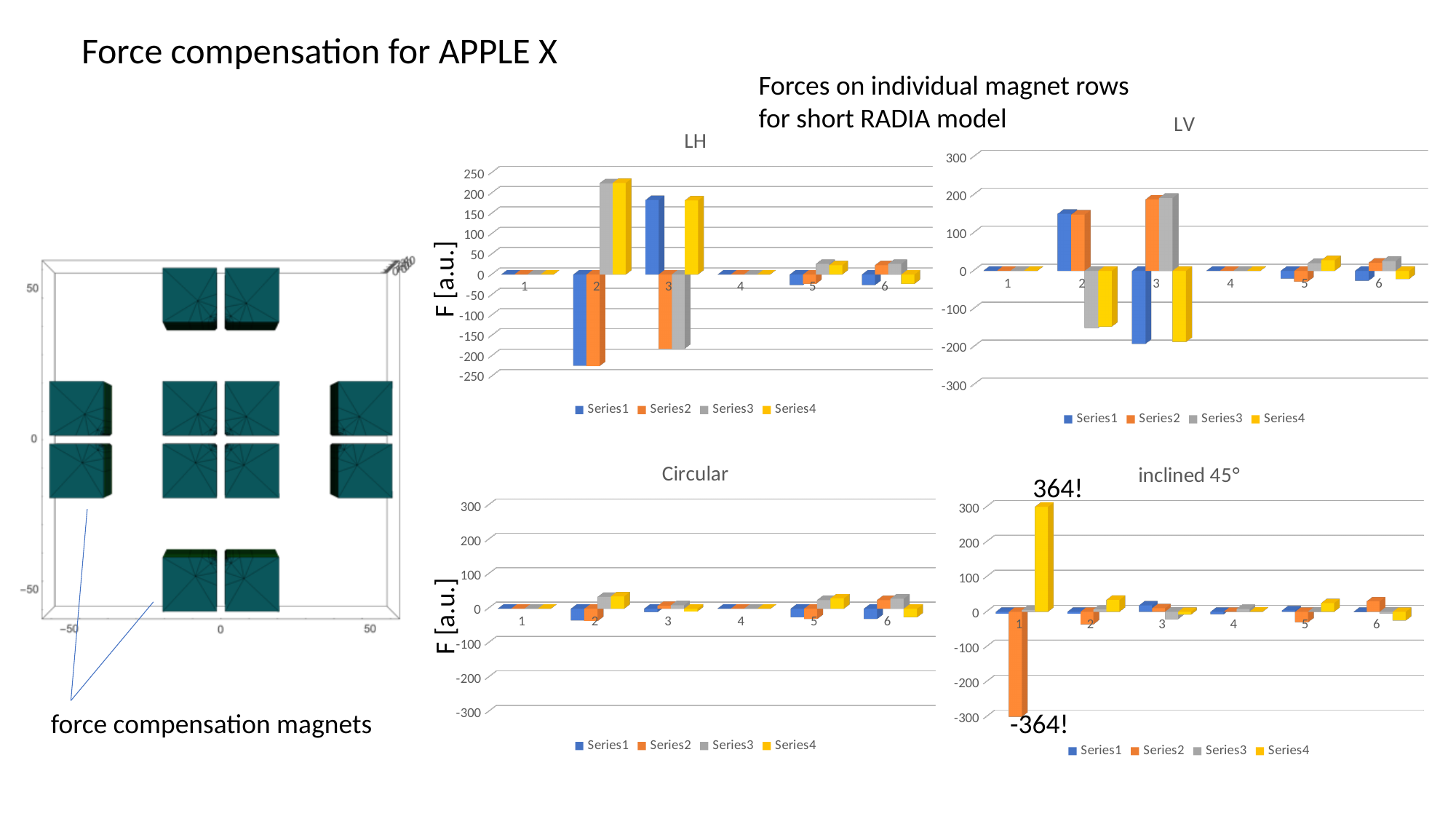
On the LH chart, is the value for Series1 at category 2 greater or less than -200? less What is the y-axis label on the Circular chart? F [a.u.] On the inclined 45° chart, which category has the tallest positive bar? 1 On the inclined 45° chart, which series has the lowest (most negative) value? Series2 What kind of chart is the LV chart? bar chart On the LV chart, is the value for Series1 at category 3 greater or less than -100? less On the inclined 45° chart, what value is annotated on the Series2 bar at category 1? -364! How many categories are shown on the x axis of the Circular chart? 6 On the LH chart, is the value for Series3 at category 2 greater or less than 200? greater On the inclined 45° chart, what value is annotated on the Series4 bar at category 1? 364! How many series does the legend of the LH chart list? 4